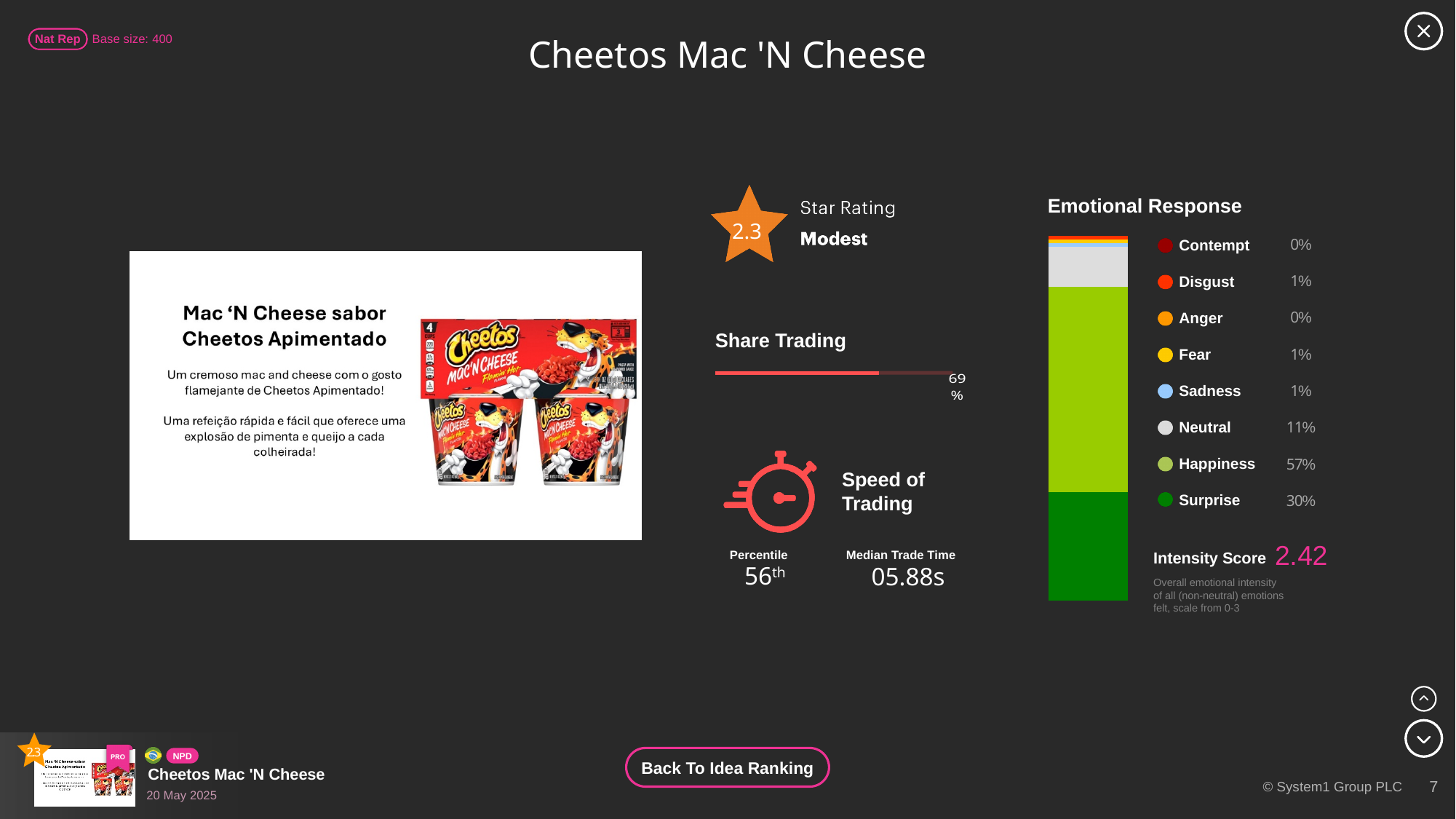
In the Emotional Response chart, what is the difference between the Happiness and Surprise percentages? 27% What value is shown on the Share Trading bar? 69% What is the title of the chart on the right side of the slide? Emotional Response In the Emotional Response chart, what percentage is shown for Surprise? 30% In the Emotional Response chart, which is larger, Surprise or Neutral? Surprise In the Emotional Response chart, what percentage is shown for Neutral? 11% What kind of chart is the Emotional Response chart? Stacked bar chart In the Emotional Response chart, what is the difference between the Surprise and Neutral percentages? 19% In the Emotional Response chart, what percentage is shown for Happiness? 57% How many emotions are listed in the Emotional Response chart? 8 In the Emotional Response chart, which emotion has the highest percentage? Happiness In the Emotional Response chart, what percentage is shown for Disgust? 1%